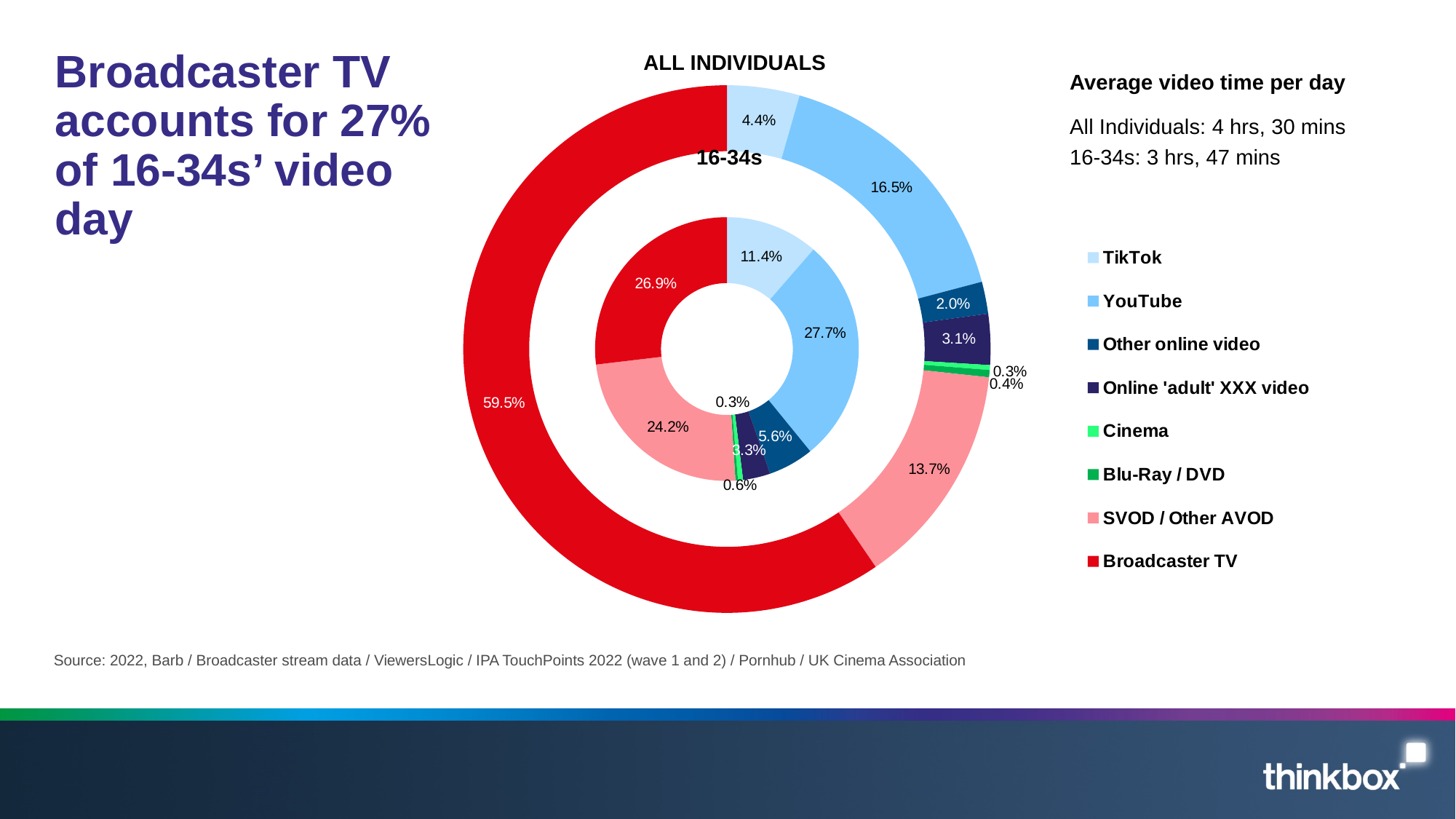
In the inner ring (16-34s), what share does TikTok account for? 11.4% In the outer ring (All Individuals), what share of the video day does Broadcaster TV account for? 59.5% Which category has the largest share in the outer ring (All Individuals)? Broadcaster TV How many categories does the legend list? 8 What is the average video time per day for 16-34s stated on the slide? 3 hrs, 47 mins In the inner ring (16-34s), which is larger: the share for SVOD / Other AVOD or the share for TikTok? SVOD / Other AVOD Which category has the largest share in the inner ring (16-34s)? YouTube In the inner ring (16-34s), what share does YouTube account for? 27.7% In the outer ring (All Individuals), what share does SVOD / Other AVOD account for? 13.7% In the inner ring (16-34s), what share does Broadcaster TV account for? 26.9% What type of chart is shown on the slide? Doughnut chart What is the difference between the Broadcaster TV share for All Individuals (59.5%) and for 16-34s (26.9%)? 32.6 percentage points